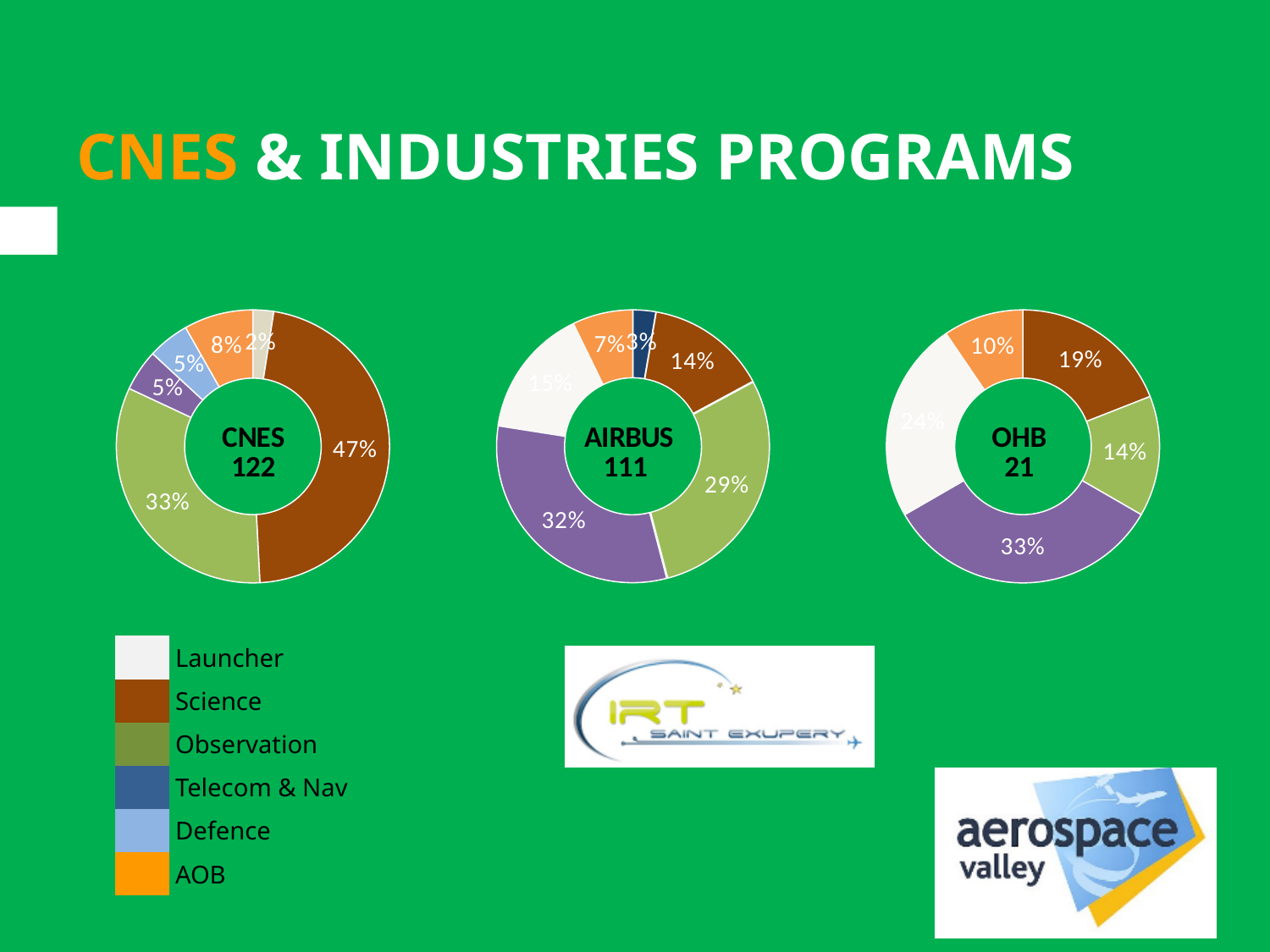
How many charts are shown on the slide? 3 In the CNES chart, how many percentage points larger is Science than Observation? 14 percentage points What kind of charts are shown on the slide? Doughnut (pie) charts In the OHB chart, what share does AOB have? 10% How many categories does the legend list? 6 In the CNES chart, what share does Science have? 47% In the CNES chart, which category has the largest share? Science In the AIRBUS chart, what share does Observation have? 29% In the OHB chart, what share does Science have? 19% What number is shown in the centre of the AIRBUS chart? 111 Which of the three charts shows the smallest total in its centre? OHB (21) Which has a larger Science share, the AIRBUS chart or the OHB chart? OHB